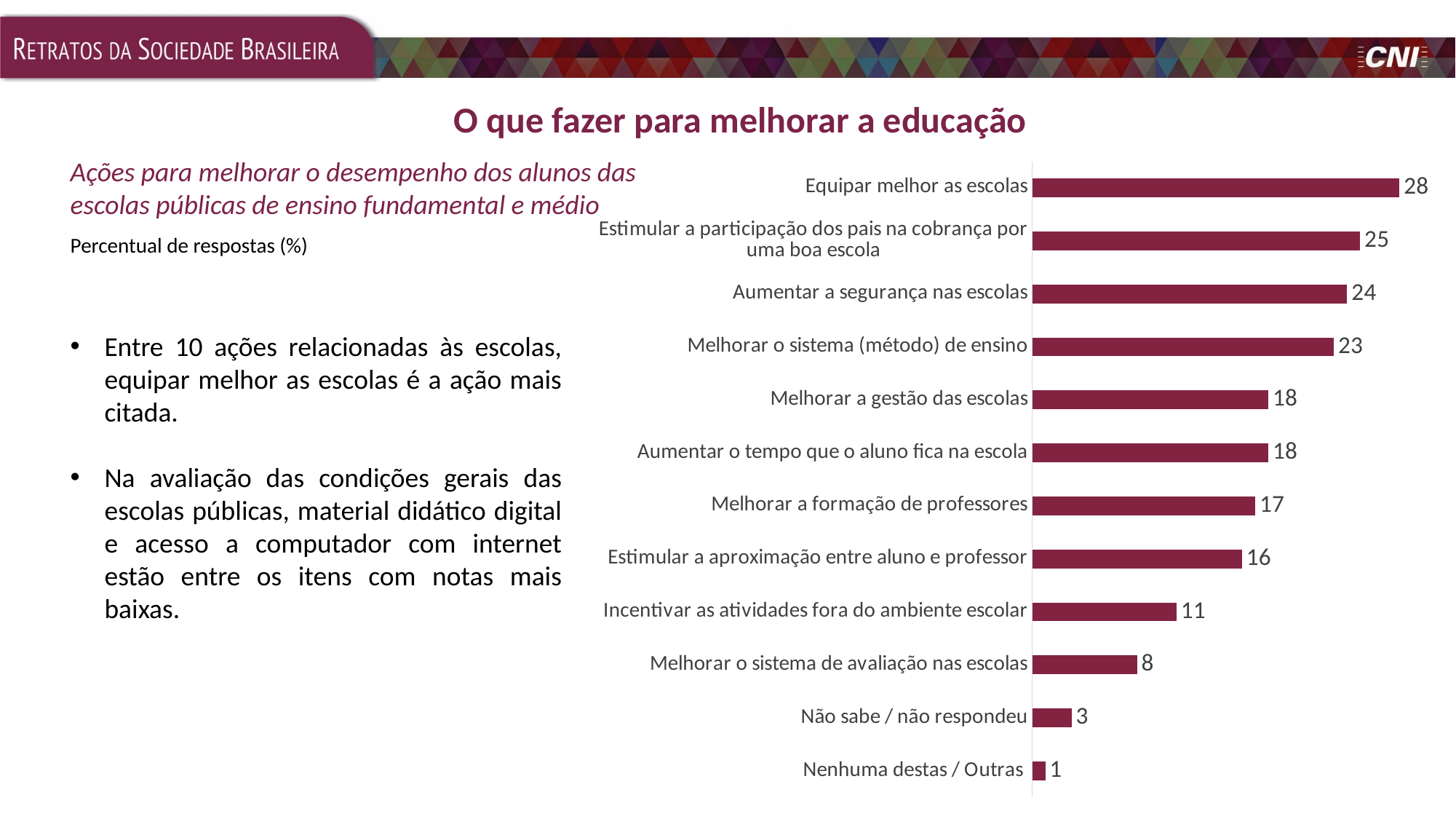
What is the value for "Equipar melhor as escolas"? 28 Which category has the lowest value? Nenhuma destas / Outras What is the value for "Não sabe / não respondeu"? 3 Which is larger: the value for "Melhorar o sistema (método) de ensino" or the value for "Melhorar a formação de professores"? Melhorar o sistema (método) de ensino What unit does the chart's subtitle say the values are in? Percentual de respostas (%) What is the value for "Melhorar o sistema de avaliação nas escolas"? 8 How many categories are shown in the chart? 12 What kind of chart is shown on the slide? Bar chart What is the difference between the values for "Equipar melhor as escolas" and "Aumentar a segurança nas escolas"? 4 What is the value for "Incentivar as atividades fora do ambiente escolar"? 11 Which category has the highest value? Equipar melhor as escolas What is the difference between the values for "Melhorar a gestão das escolas" and "Melhorar o sistema de avaliação nas escolas"? 10